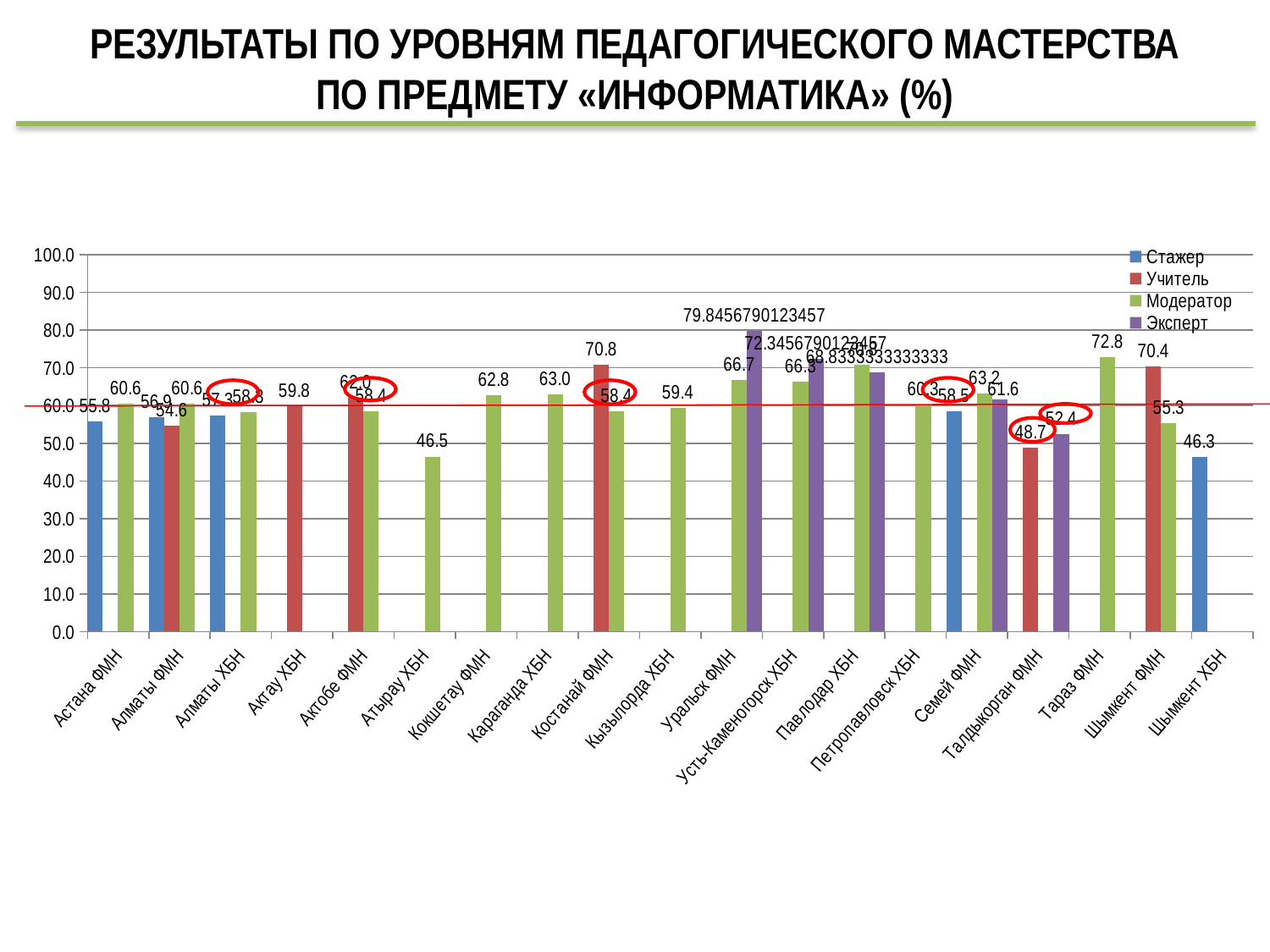
Which category has the highest Модератор value? Тараз ФМН Which category has the lowest Стажер value? Шымкент ХБН For Талдыкорган ФМН, which is larger: the Учитель value or the Эксперт value? Эксперт What is the Модератор value for Кокшетау ФМН? 62.8 What is the Модератор value for Атырау ХБН? 46.5 What kind of chart is shown on the slide? bar chart Is the Эксперт value for Усть-Каменогорск ХБН greater or less than 70.0? greater What is the Учитель value for Костанай ФМН? 70.8 What colour represents the Эксперт series in the legend? purple What is the difference between the Учитель and Модератор values for Шымкент ФМН? 15.1 How many series does the legend list? 4 What is the Эксперт value for Уральск ФМН? 79.8456790123457